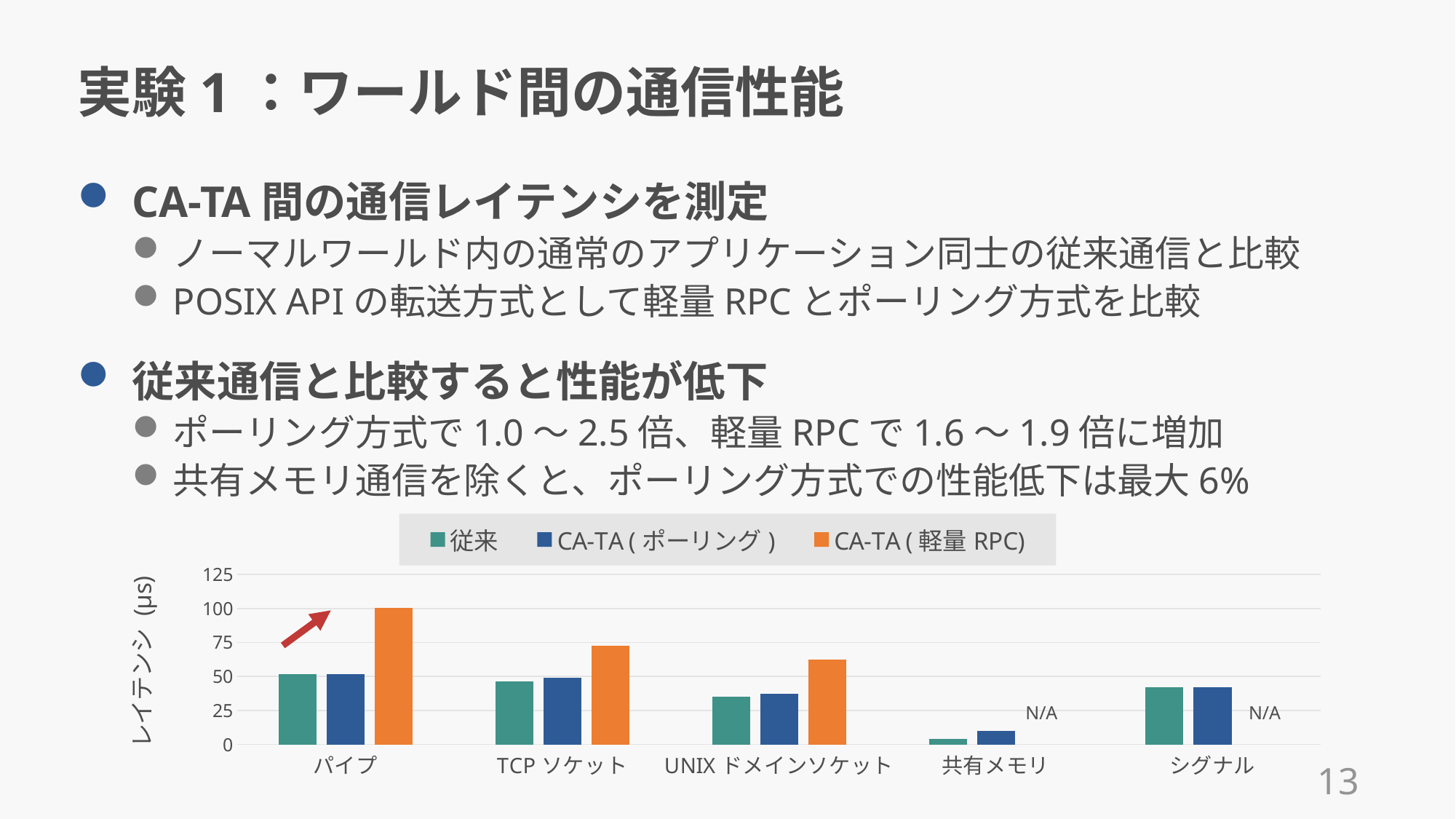
How many series does the chart legend list? 3 What kind of chart is shown on the slide? bar chart Is the 従来 value for UNIX ドメインソケット greater or less than 50? less Is the CA-TA ( ポーリング ) value for 共有メモリ greater or less than 25? less Which category has the highest CA-TA ( 軽量 RPC) bar? パイプ What is the label of the y axis of the chart? レイテンシ (µs) Is the CA-TA ( 軽量 RPC) value for TCP ソケット greater or less than 50? greater For which categories is the CA-TA ( 軽量 RPC) value marked as N/A? 共有メモリ and シグナル For TCP ソケット, which is larger: the 従来 value or the CA-TA ( 軽量 RPC) value? CA-TA ( 軽量 RPC) How many categories are shown on the x axis of the chart? 5 Which category has the lowest 従来 bar? 共有メモリ